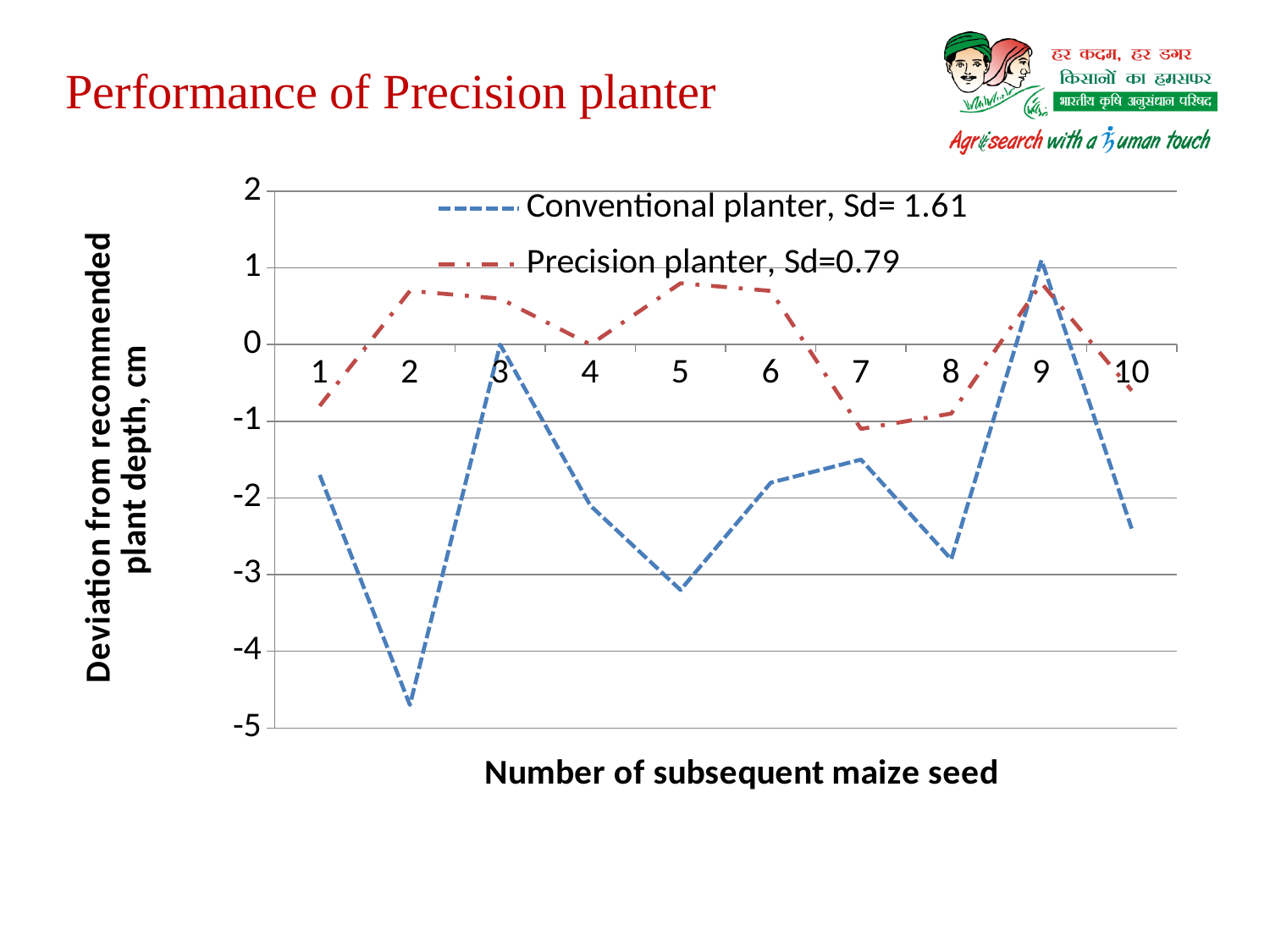
At seed 2, which series has the higher value, Conventional planter or Precision planter? Precision planter What is the title of the x axis? Number of subsequent maize seed How many seed numbers are plotted along the x axis? 10 What standard deviation (Sd) does the legend give for the Conventional planter? 1.61 At which seed number does the Conventional planter series reach its lowest value? 2 What kind of chart is shown on the slide? line chart At which seed number does the Conventional planter series reach its highest value? 9 Is the Precision planter value at seed 5 greater or less than 0? greater Is the Conventional planter value at seed 2 greater or less than -4? less How many series does the legend list? 2 Is the Precision planter value at seed 7 greater or less than 0? less